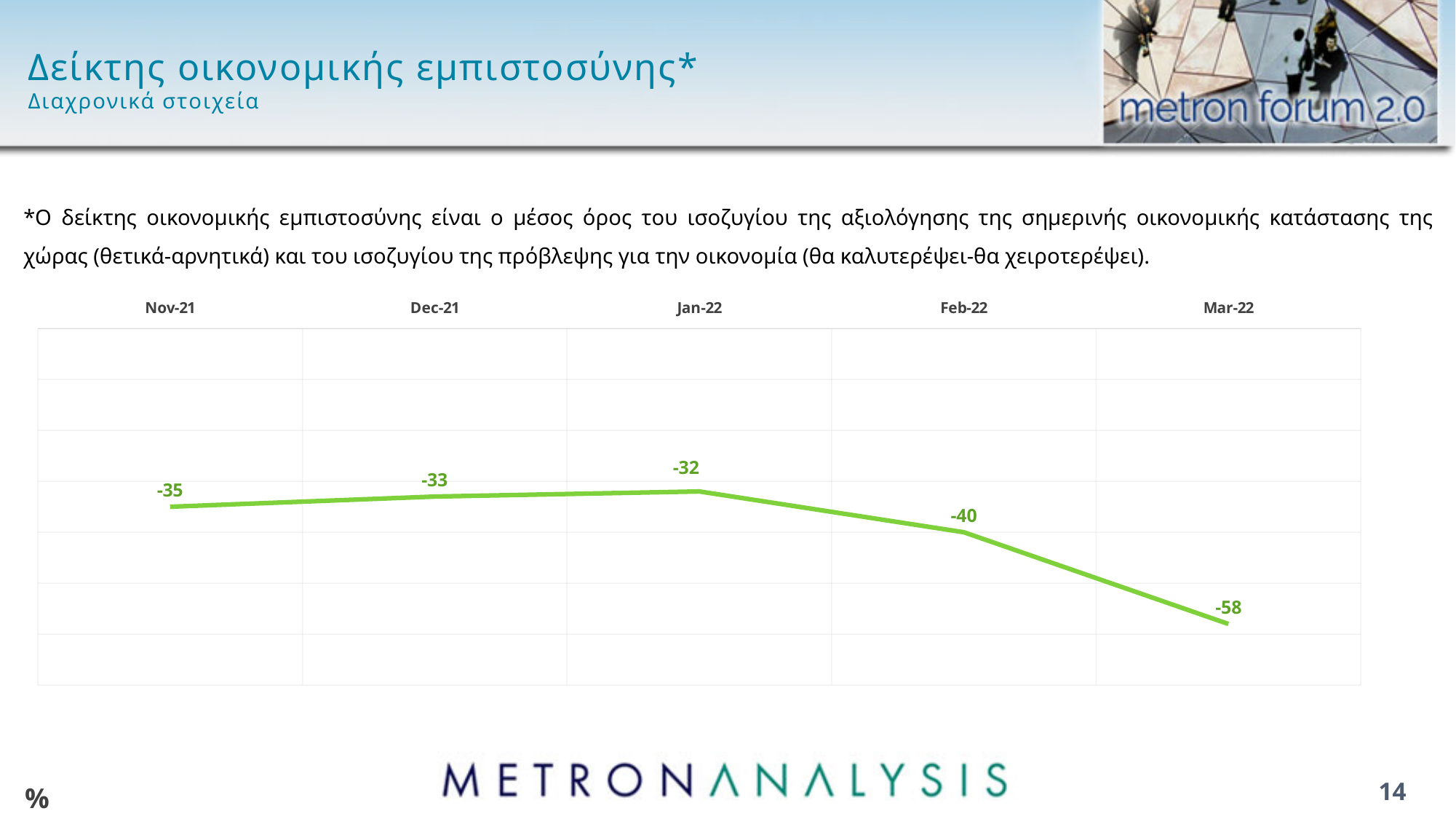
What is the value of the economic confidence index for Feb-22? -40 Which month has the lowest value of the economic confidence index? Mar-22 Which month has the highest value of the economic confidence index? Jan-22 What is the difference between the Nov-21 and Dec-21 values of the index? 2 What is the value of the economic confidence index for Mar-22? -58 What is the difference between the Feb-22 and Mar-22 values of the index? 18 What kind of chart is shown on the slide? line chart What is the value of the economic confidence index for Jan-22? -32 How many months are plotted on the chart? 5 Does the index rise or fall from Jan-22 to Mar-22? fall What is the value of the economic confidence index for Nov-21? -35 Which is larger, the value for Dec-21 or the value for Feb-22? Dec-21